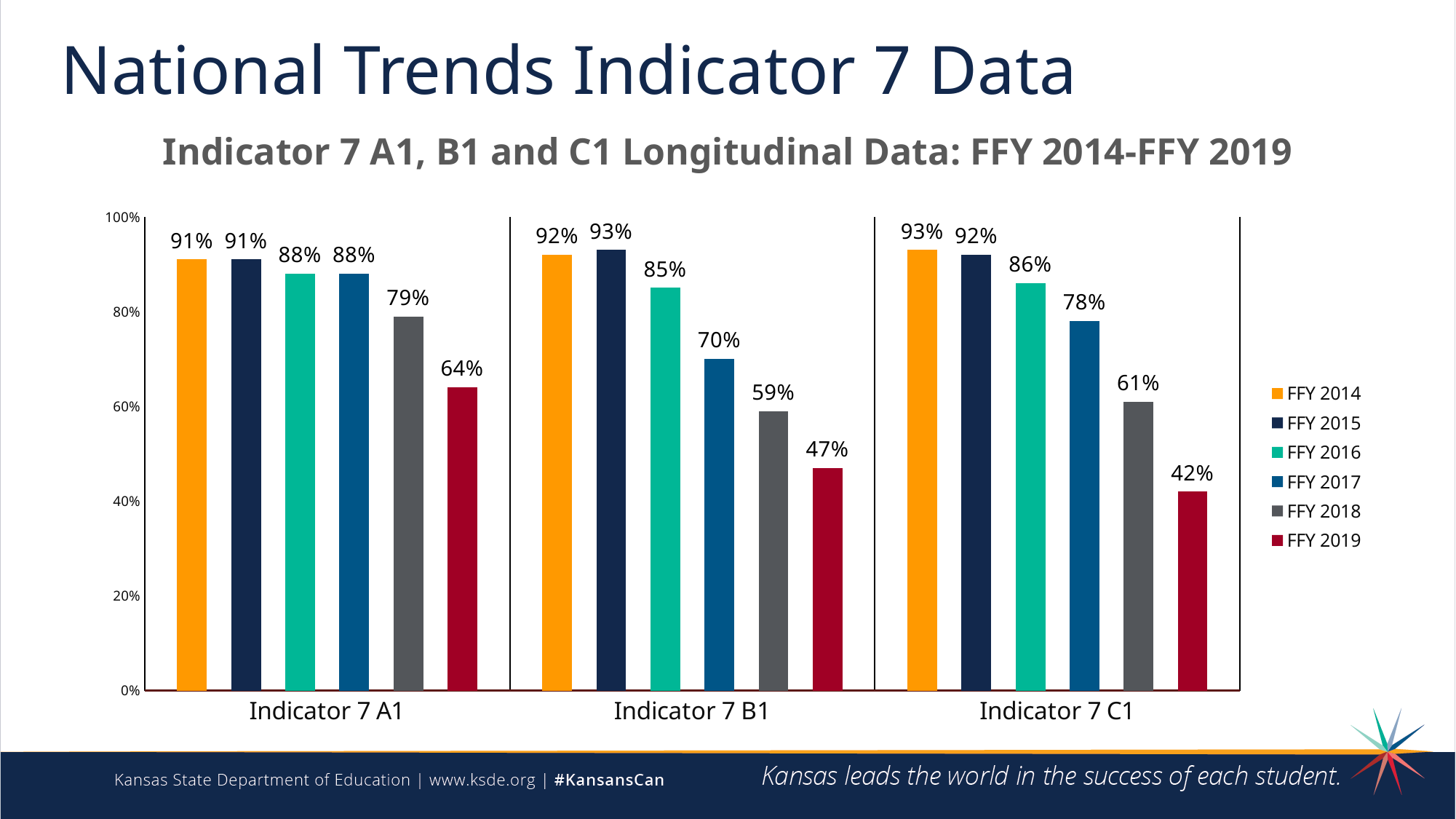
What is the FFY 2018 value for Indicator 7 C1? 61% What is the FFY 2019 value for Indicator 7 A1? 64% How many indicator categories are shown on the x axis? 3 What kind of chart is shown on the slide? Bar chart What is the difference between the FFY 2018 and FFY 2019 values for Indicator 7 A1? 15% Which year has the lowest value for Indicator 7 C1? FFY 2019 Which year has the highest value for Indicator 7 B1? FFY 2015 Do the values for Indicator 7 C1 generally rise or fall from FFY 2014 to FFY 2019? Fall What is the difference between the FFY 2014 and FFY 2019 values for Indicator 7 B1? 45% What is the FFY 2017 value for Indicator 7 B1? 70% How many series does the legend list? 6 Which is larger: the FFY 2017 value for Indicator 7 A1 or the FFY 2017 value for Indicator 7 C1? Indicator 7 A1